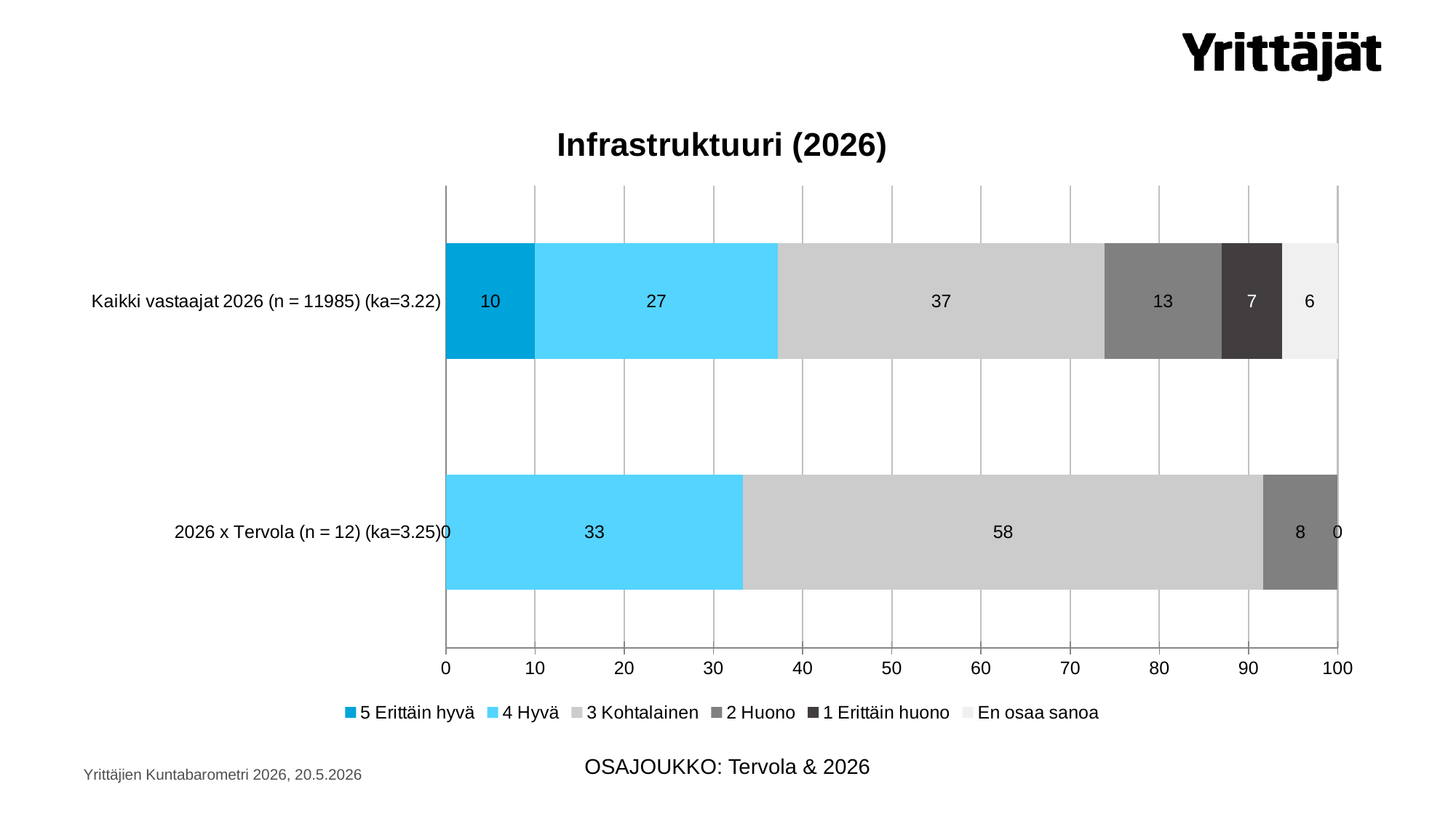
What is the value of "1 Erittäin huono" for "Kaikki vastaajat 2026 (n = 11985) (ka=3.22)"? 7 What is the title of the chart? Infrastruktuuri (2026) How many series does the legend list? 6 Which category has the higher value for "3 Kohtalainen": "Kaikki vastaajat 2026" or "2026 x Tervola"? 2026 x Tervola What is the difference between the "3 Kohtalainen" values of "2026 x Tervola" and "Kaikki vastaajat 2026"? 21 What is the value of "3 Kohtalainen" for "Kaikki vastaajat 2026 (n = 11985) (ka=3.22)"? 37 How many categories (bars) are shown in the chart? 2 What is the value of "5 Erittäin hyvä" for "Kaikki vastaajat 2026 (n = 11985) (ka=3.22)"? 10 What is the value of "2 Huono" for "2026 x Tervola (n = 12) (ka=3.25)"? 8 Which series has the largest value in the "Kaikki vastaajat 2026 (n = 11985) (ka=3.22)" bar? 3 Kohtalainen What type of chart is shown on the slide? stacked bar chart What is the value of "4 Hyvä" for "2026 x Tervola (n = 12) (ka=3.25)"? 33